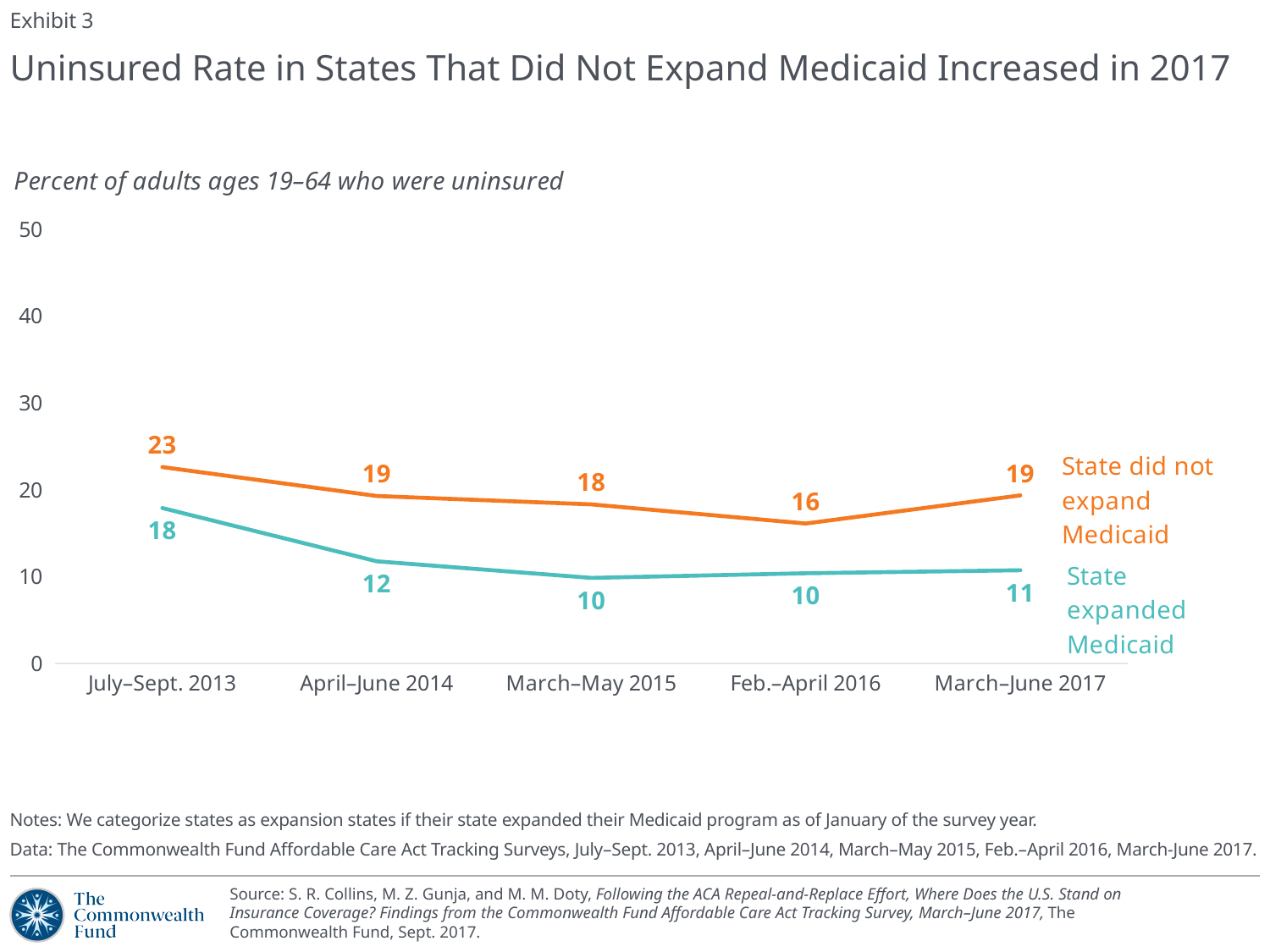
Did the uninsured rate for states that did not expand Medicaid rise or fall between Feb.–April 2016 and March–June 2017? Rise What was the uninsured rate for states that expanded Medicaid in March–June 2017? 11 What was the uninsured rate for states that did not expand Medicaid in Feb.–April 2016? 16 What is the difference between the uninsured rates of non-expansion and expansion states in March–June 2017? 8 How many survey periods are shown on the x axis? 5 What type of chart is shown on the slide? Line chart How many series are plotted on the chart? 2 What was the uninsured rate for states that did not expand Medicaid in July–Sept. 2013? 23 In which period was the uninsured rate for states that did not expand Medicaid highest? July–Sept. 2013 By how much did the uninsured rate for states that did not expand Medicaid change from Feb.–April 2016 to March–June 2017? 3 What is the lowest uninsured rate shown for states that expanded Medicaid? 10 Which group had the higher uninsured rate in April–June 2014: states that expanded Medicaid or states that did not? State did not expand Medicaid